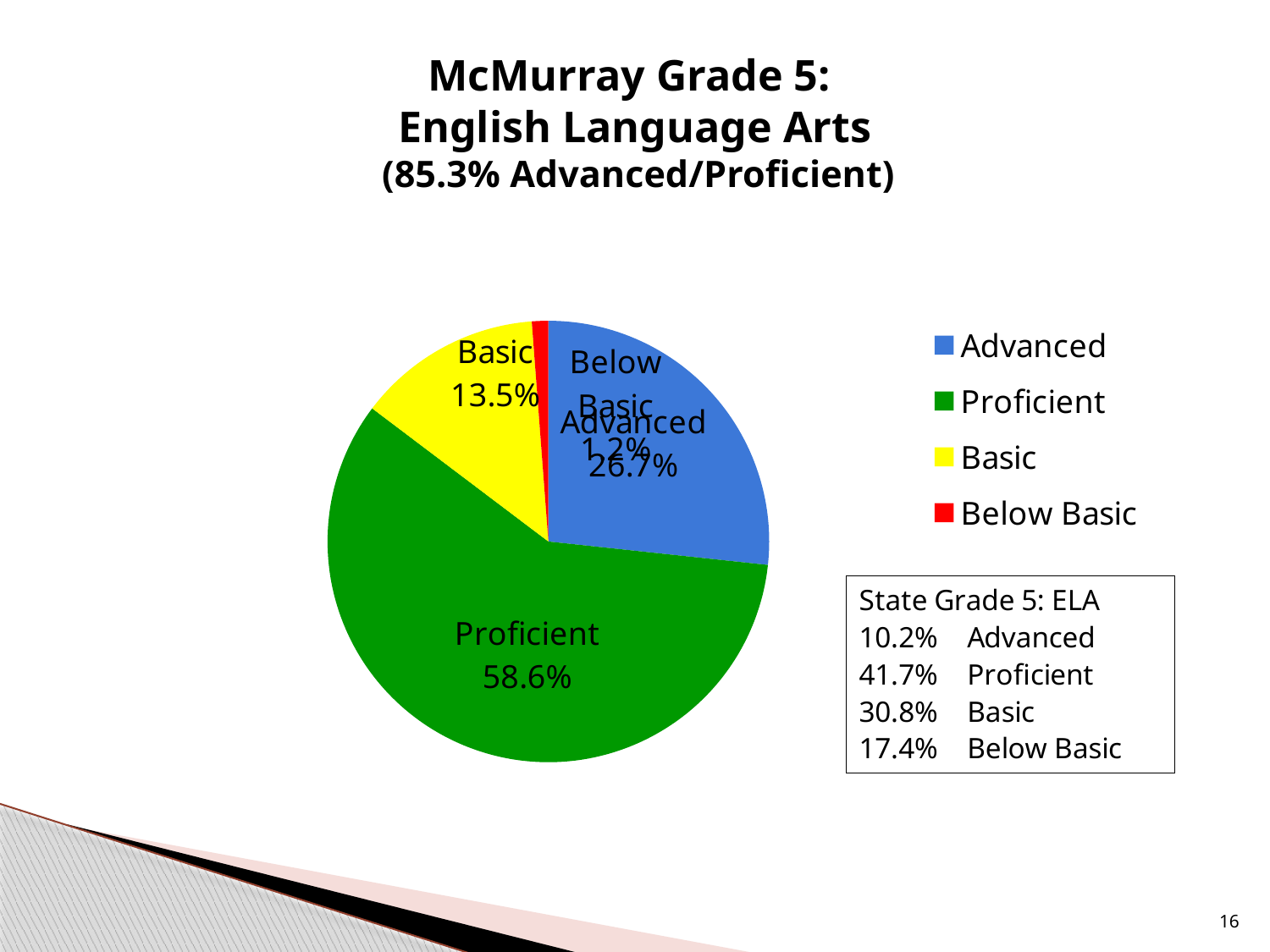
What percentage of students are Below Basic according to the pie chart? 1.2% What percentage of students are Advanced according to the pie chart? 26.7% How many entries does the legend list? 4 Which is larger, the Basic slice or the Advanced slice? Advanced Which category has the smallest slice of the pie chart? Below Basic What is the difference in percentage points between Proficient and Advanced? 31.9 What type of chart is shown on the slide? pie chart Which category has the largest slice of the pie chart? Proficient How many categories does the pie chart show? 4 What percentage of students are Proficient according to the pie chart? 58.6% What percentage of students are Basic according to the pie chart? 13.5% What colour is the Basic slice in the pie chart? yellow